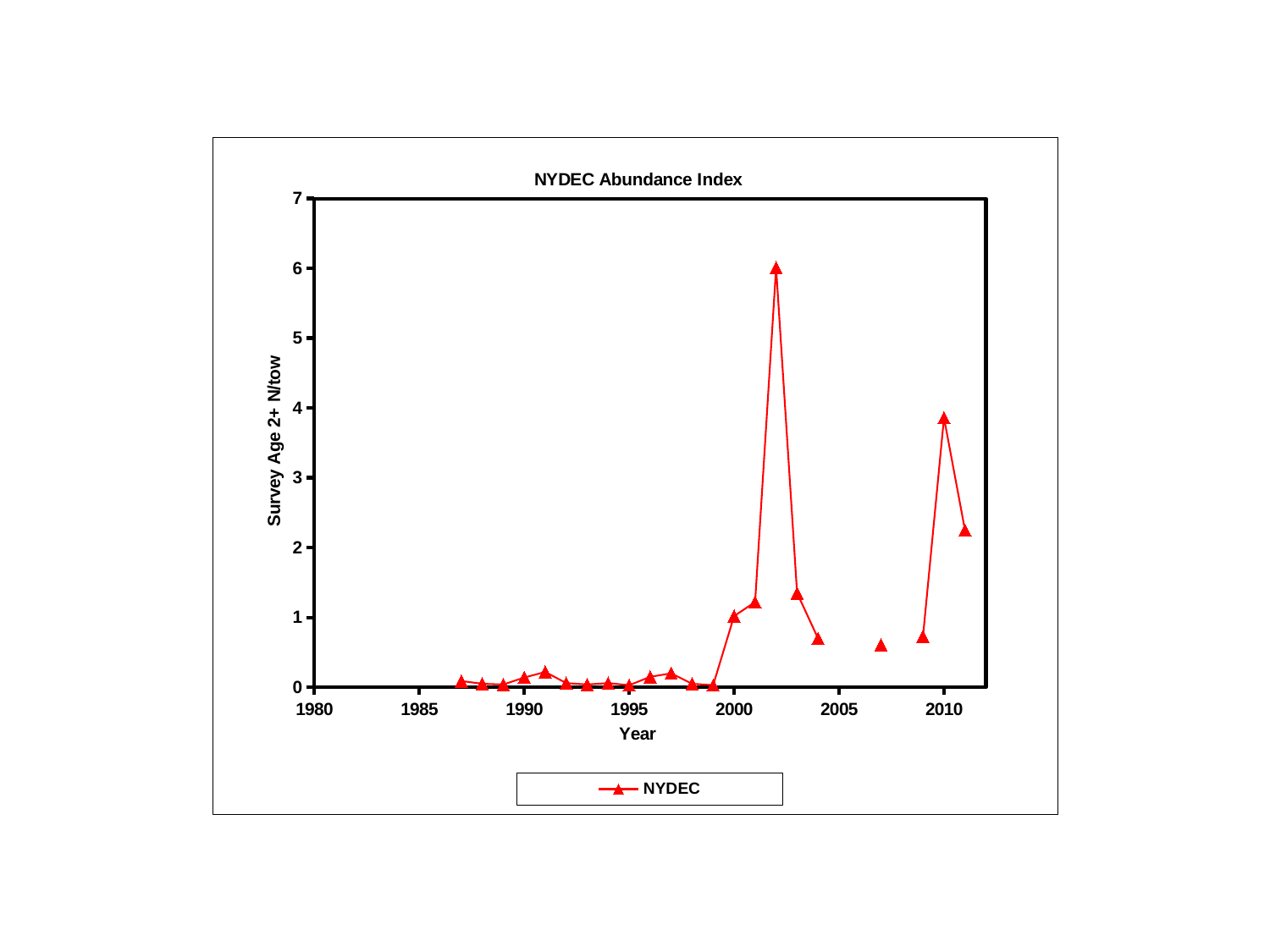
How many series does the legend list? 1 Is the value for 2010 greater or less than 3? greater Do the values rise or fall from 2000 to 2002? rise What is the label on the vertical axis? Survey Age 2+ N/tow Which year has the larger value, 2003 or 2004? 2003 What is the name of the series shown in the legend? NYDEC In which year does the NYDEC Abundance Index reach its highest value? 2002 What kind of chart is shown on the slide? line chart Is the value for 1995 greater or less than 1? less Do the values rise or fall from 2002 to 2004? fall Is the value for 2002 greater or less than 5? greater Which year has the larger value, 2002 or 2010? 2002